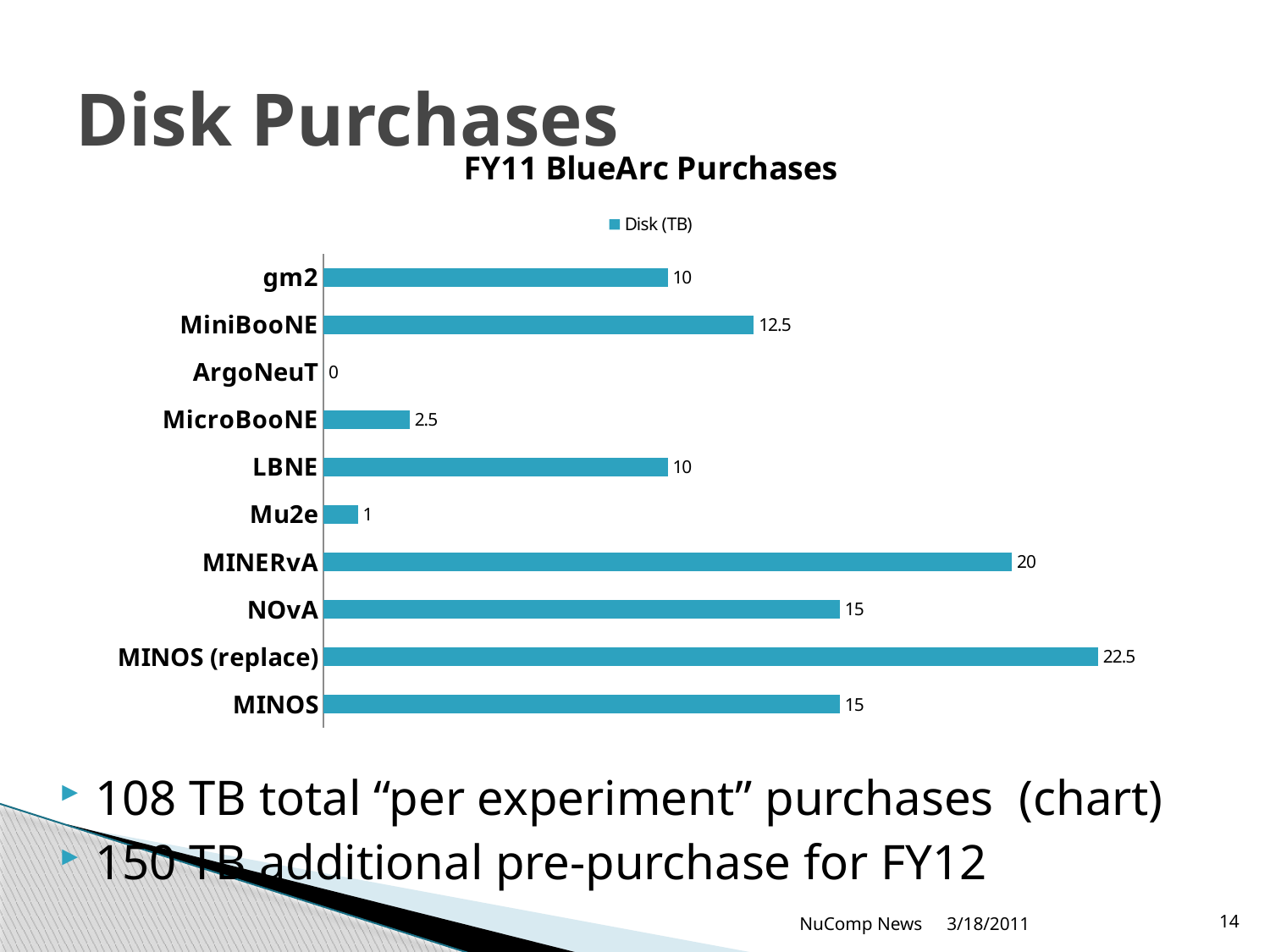
What is the Disk (TB) value for MiniBooNE? 12.5 Which has a larger Disk (TB) value, NOvA or LBNE? NOvA What is the title of the chart? FY11 BlueArc Purchases What kind of chart is shown on the slide? Bar chart What is the Disk (TB) value for MicroBooNE? 2.5 How many series does the legend list? 1 What is the Disk (TB) value for MINERvA? 20 What is the difference between the Disk (TB) values for MINOS (replace) and MINOS? 7.5 What is the difference between the Disk (TB) values for MINERvA and Mu2e? 19 Which category has the lowest Disk (TB) value? ArgoNeuT Which category has the highest Disk (TB) value? MINOS (replace) How many categories are shown in the chart? 10